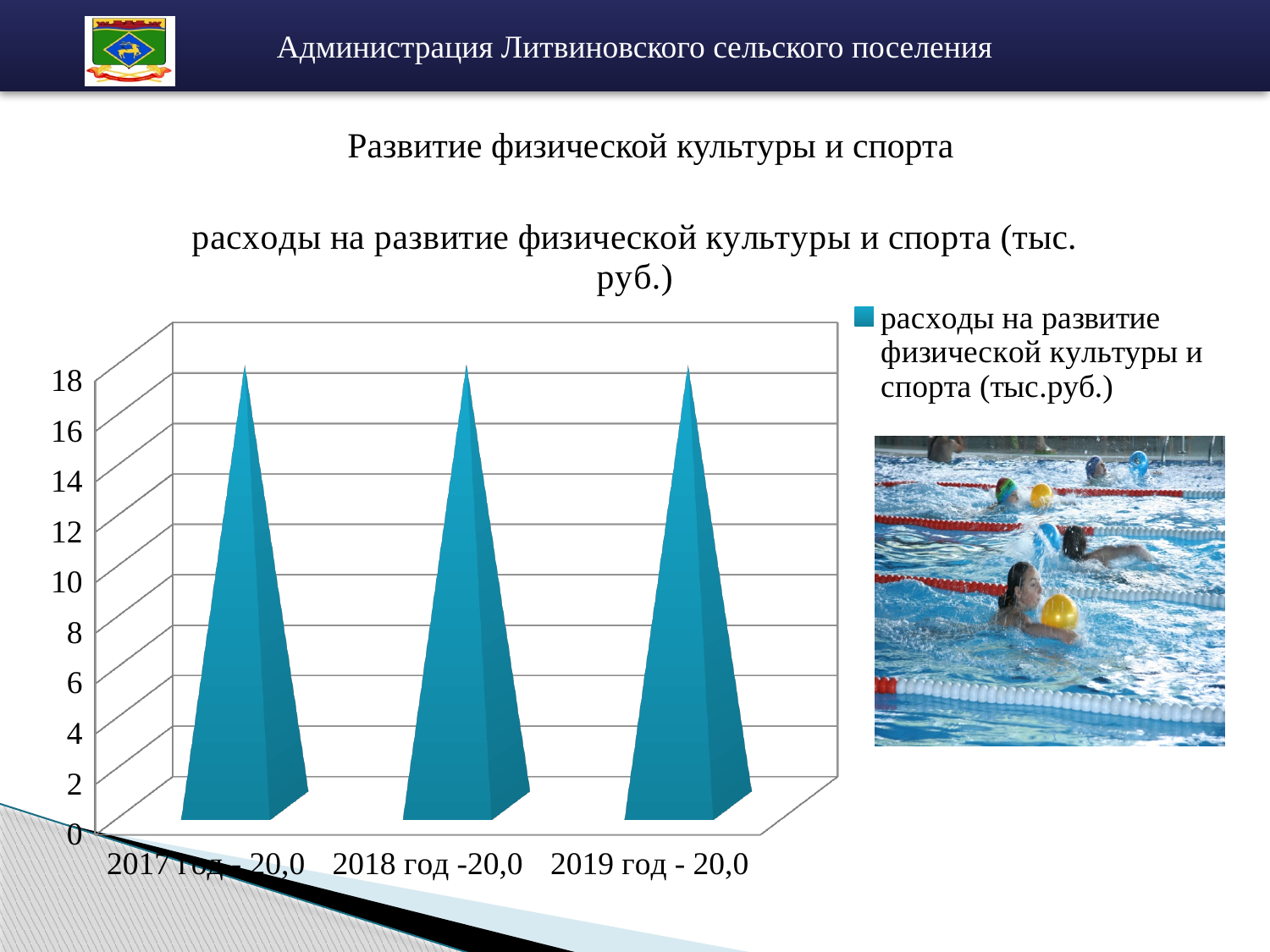
How many series does the legend list? 1 What is the title of the chart? расходы на развитие физической культуры и спорта (тыс. руб.) What value is given for 2017 год in the category label? 20,0 What kind of chart is shown on the slide? bar chart Is the value for 2019 год greater or less than 16? greater What is the highest tick value shown on the vertical axis? 18 How many categories (years) are plotted in the chart? 3 What is the legend entry of the chart? расходы на развитие физической культуры и спорта (тыс.руб.) Do the values rise, fall or stay the same from 2017 to 2019? stay the same What value is given for 2018 год in the category label? 20,0 Is the value for 2017 год greater or less than 10? greater What value is given for 2019 год in the category label? 20,0